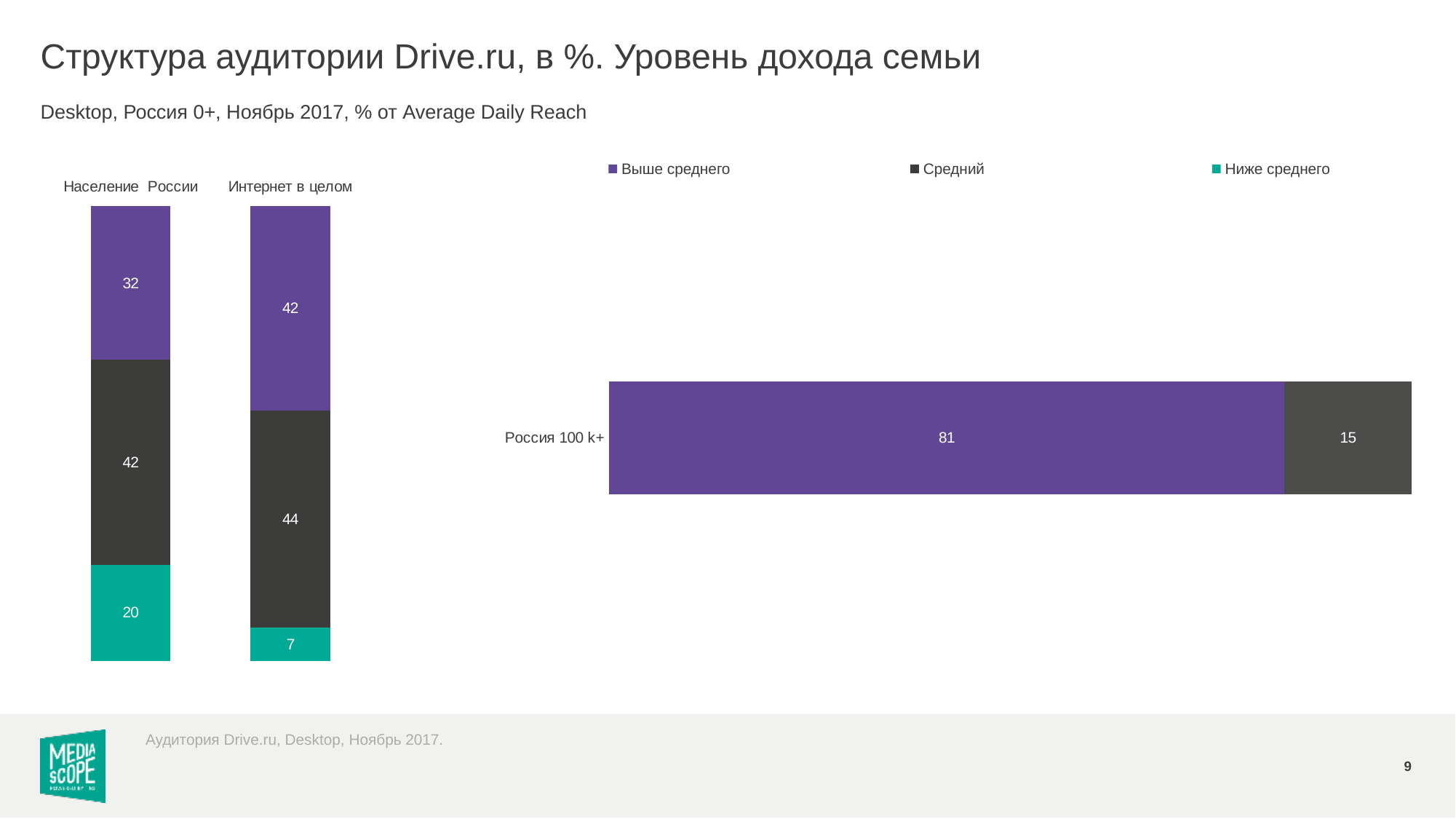
In the right chart, what is the value for 'Выше среднего' for 'Россия 100 k+'? 81 In the left chart, what is the value for 'Выше среднего' for 'Население России'? 32 In the left chart, which segment is the smallest for 'Интернет в целом'? Ниже среднего In the left chart, which has the larger 'Выше среднего' value: 'Население России' or 'Интернет в целом'? Интернет в целом In the left chart, what is the value for 'Ниже среднего' for 'Интернет в целом'? 7 What kind of chart is the right chart? Stacked bar chart How many series does the legend list? 3 In the left chart, which segment is the largest for 'Население России'? Средний In the right chart, what is the value for 'Средний' for 'Россия 100 k+'? 15 In the left chart, what is the value for 'Средний' for 'Интернет в целом'? 44 In the left chart, what is the difference between the 'Ниже среднего' values for 'Население России' and 'Интернет в целом'? 13 In the right chart, what is the difference between the 'Выше среднего' and 'Средний' values for 'Россия 100 k+'? 66